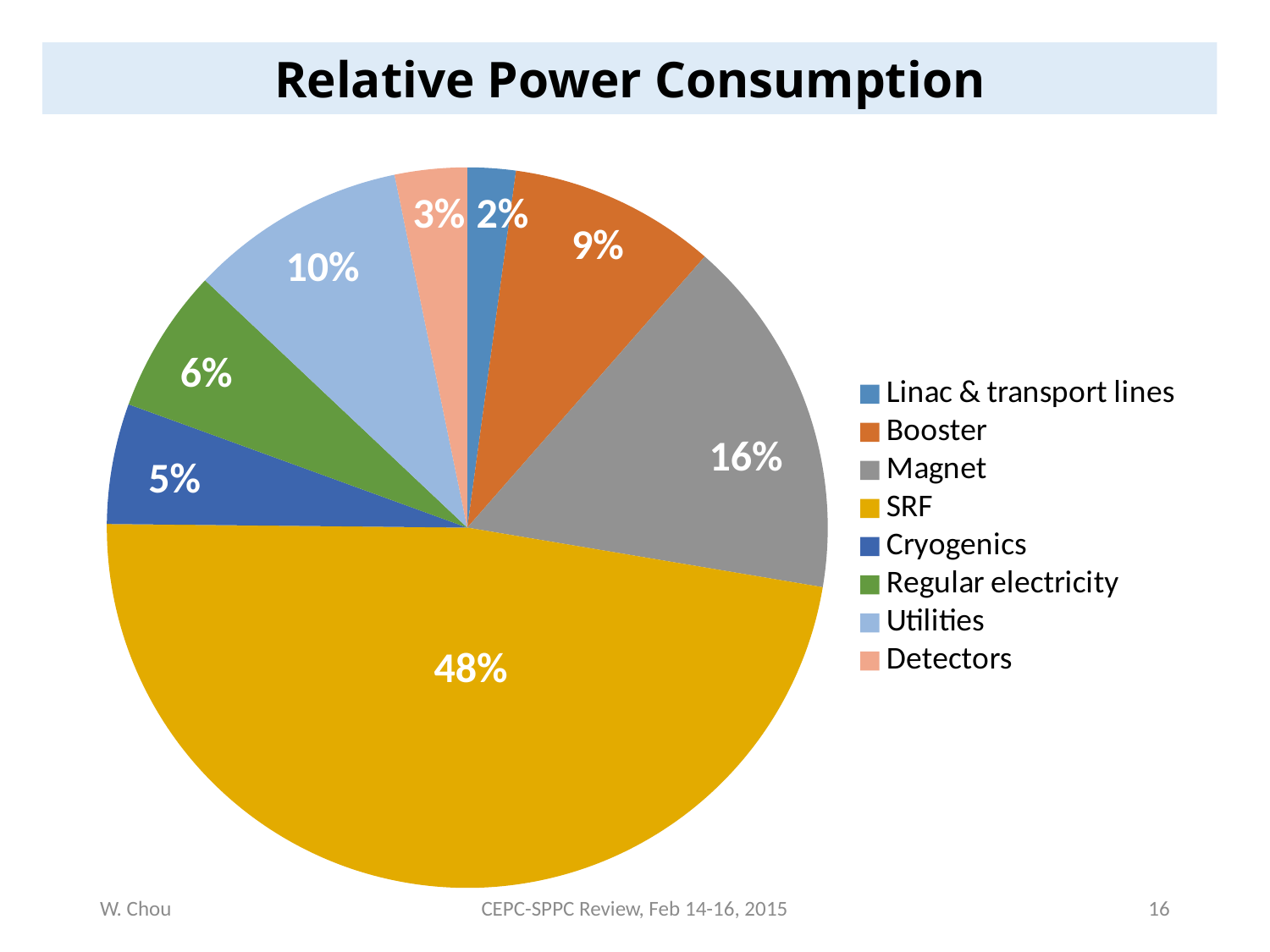
What is the title of the chart? Relative Power Consumption What share of power consumption does Magnet account for? 16% Which has a larger share, Regular electricity or Detectors? Regular electricity What share of power consumption does Cryogenics account for? 5% How many categories does the legend list? 8 What share of power consumption does Booster account for? 9% What is the difference between the shares of Magnet and Booster? 7% Which category has the smallest share of power consumption? Linac & transport lines Which category has the largest share of power consumption? SRF What type of chart is shown on the slide? pie chart